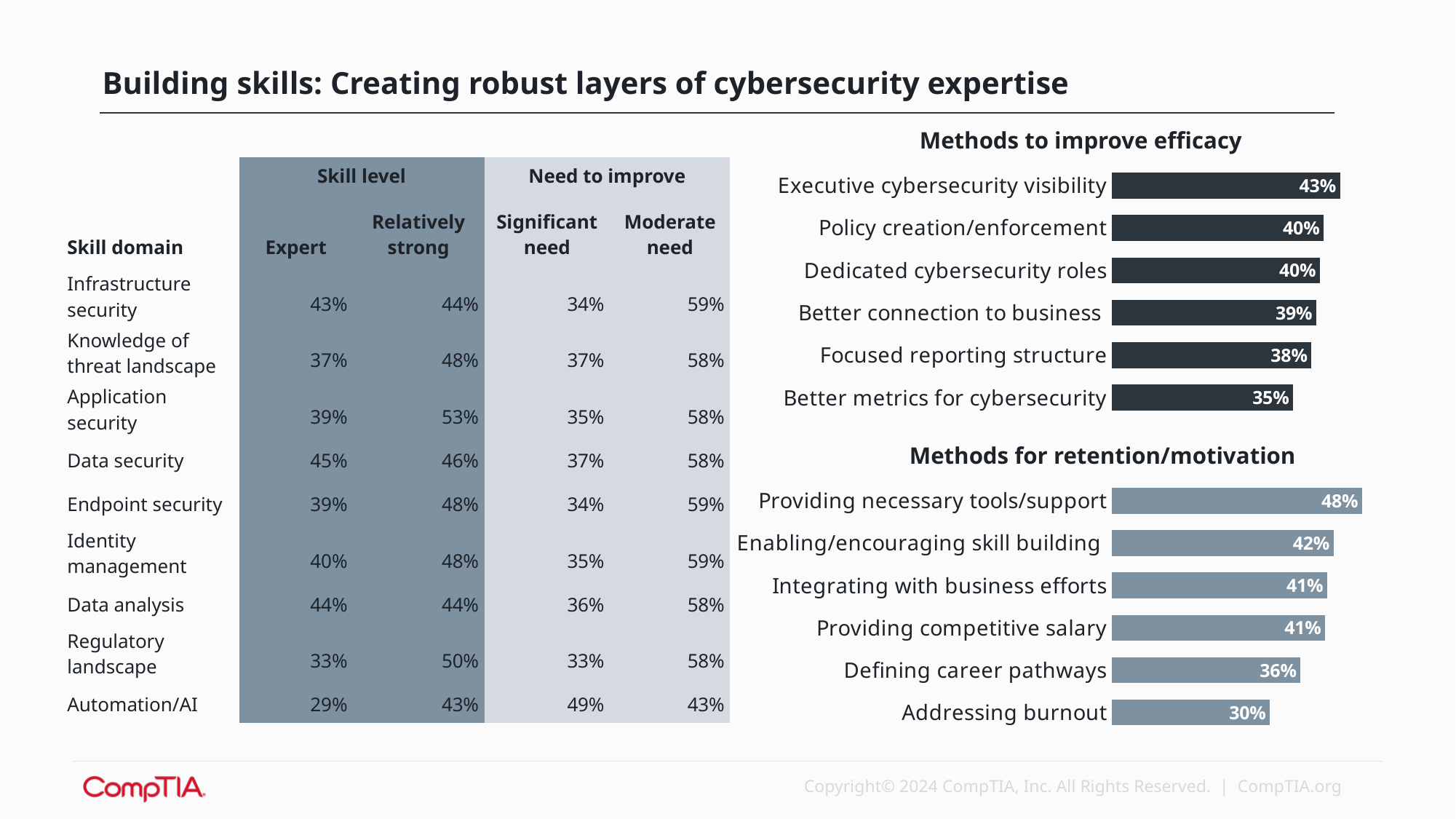
In the 'Methods to improve efficacy' chart, what is the difference between Executive cybersecurity visibility and Better metrics for cybersecurity? 8% In the 'Methods for retention/motivation' chart, what is the value for Providing necessary tools/support? 48% In the 'Methods for retention/motivation' chart, how many methods are shown? 6 In the 'Methods for retention/motivation' chart, what is the value for Addressing burnout? 30% In the 'Methods to improve efficacy' chart, which method has the lowest value? Better metrics for cybersecurity In the 'Methods to improve efficacy' chart, what is the value for Focused reporting structure? 38% In the 'Methods for retention/motivation' chart, which method has the highest value? Providing necessary tools/support In the 'Methods to improve efficacy' chart, how many methods are shown? 6 In the 'Methods to improve efficacy' chart, what is the value for Executive cybersecurity visibility? 43% What kind of chart is 'Methods for retention/motivation'? Bar chart In the 'Methods for retention/motivation' chart, what is the difference between Providing necessary tools/support and Addressing burnout? 18% In the 'Methods for retention/motivation' chart, which is larger: Enabling/encouraging skill building or Defining career pathways? Enabling/encouraging skill building